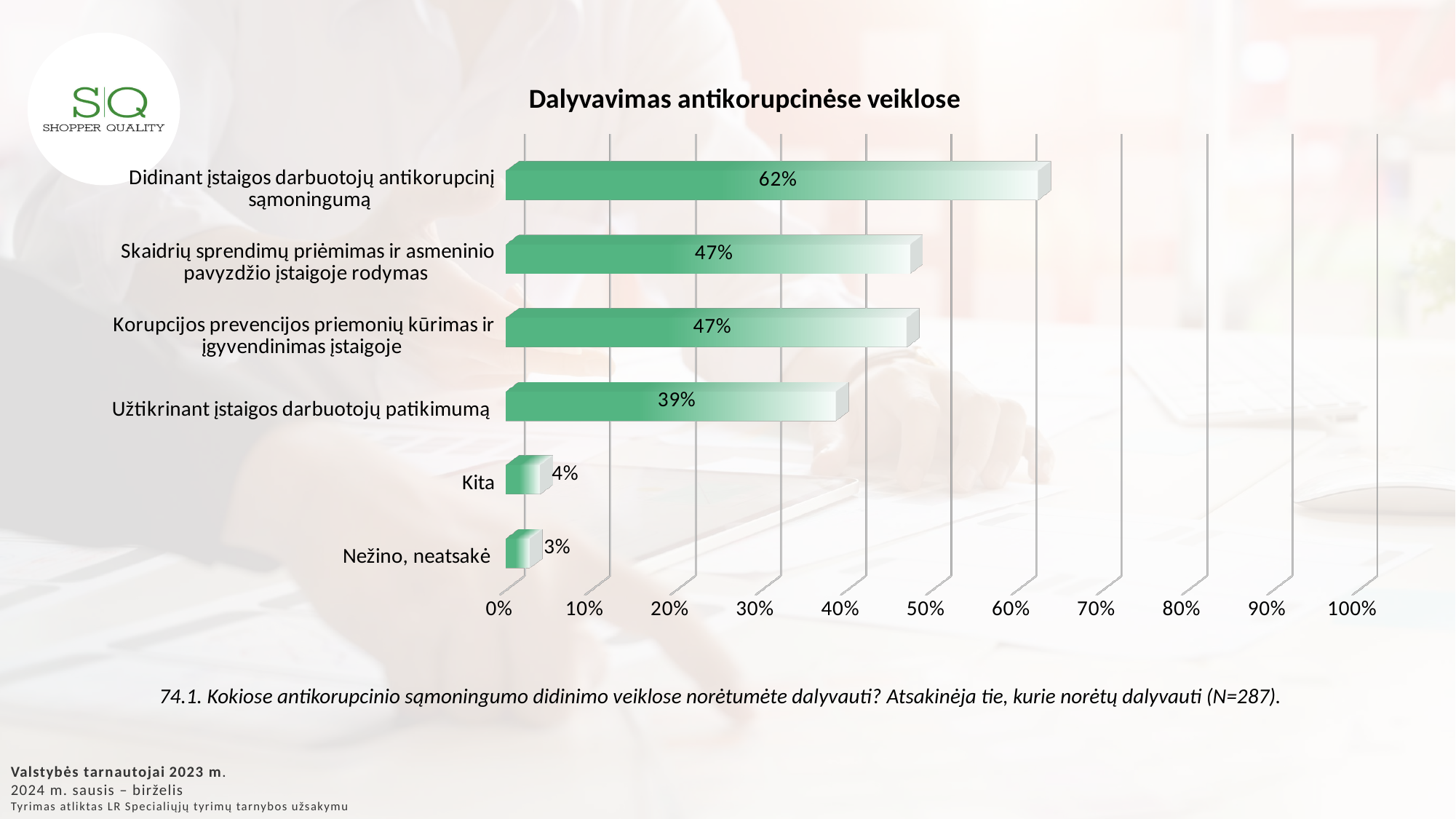
What is the value for "Užtikrinant įstaigos darbuotojų patikimumą"? 39% How many categories are shown in the chart? 6 What is the value for "Didinant įstaigos darbuotojų antikorupcinį sąmoningumą"? 62% What is the value for "Kita"? 4% Which category has the highest value? Didinant įstaigos darbuotojų antikorupcinį sąmoningumą Which category has the lowest value? Nežino, neatsakė What is the title of the chart? Dalyvavimas antikorupcinėse veiklose What is the difference between the values for "Didinant įstaigos darbuotojų antikorupcinį sąmoningumą" and "Užtikrinant įstaigos darbuotojų patikimumą"? 23% What kind of chart is shown on the slide? bar chart What is the value for "Nežino, neatsakė"? 3% Is the value for "Korupcijos prevencijos priemonių kūrimas ir įgyvendinimas įstaigoje" greater or less than 50%? less Which is larger: the value for "Skaidrių sprendimų priėmimas ir asmeninio pavyzdžio įstaigoje rodymas" or the value for "Užtikrinant įstaigos darbuotojų patikimumą"? Skaidrių sprendimų priėmimas ir asmeninio pavyzdžio įstaigoje rodymas